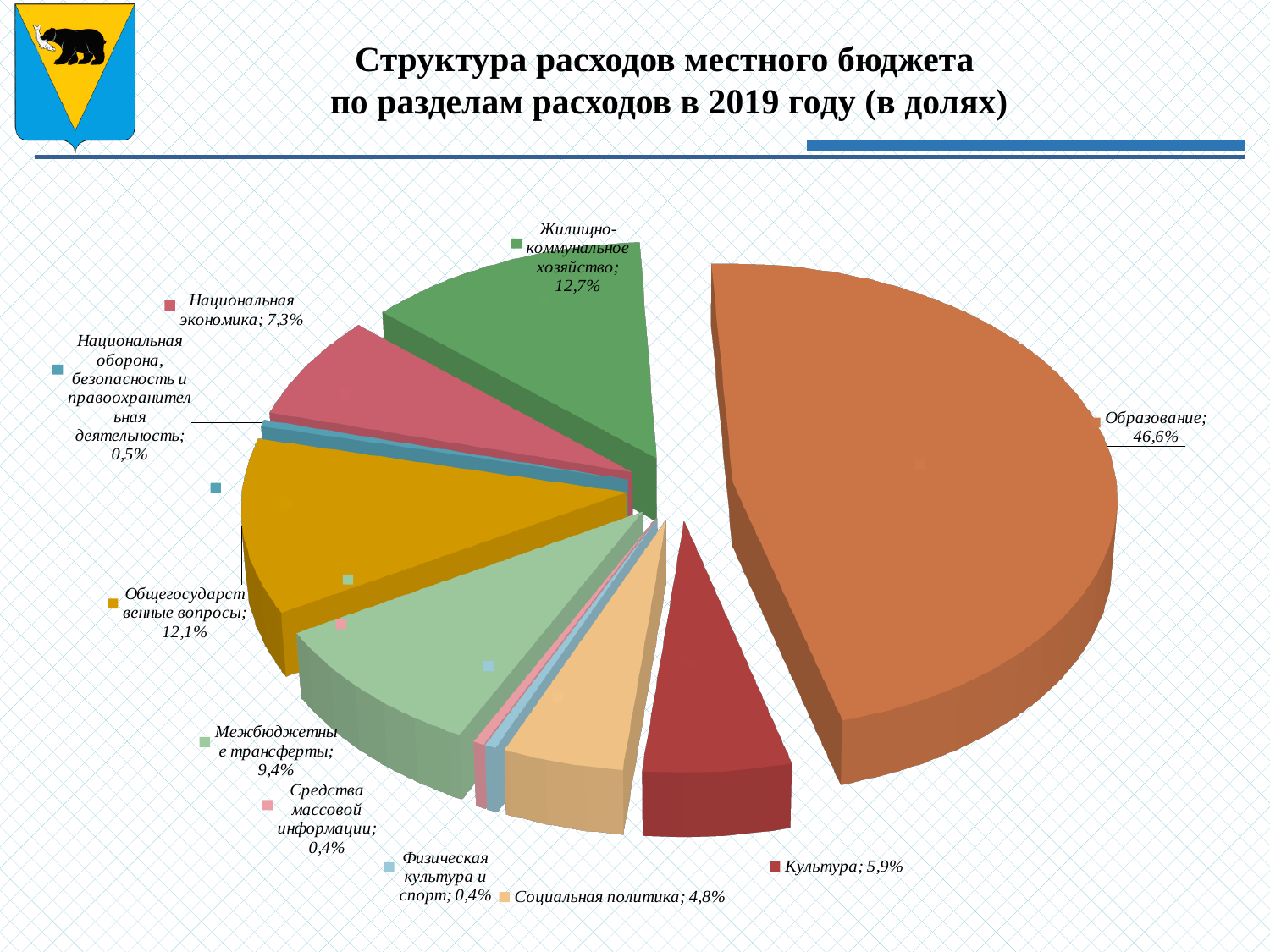
What year does the chart title refer to? 2019 What is the share for Межбюджетные трансферты? 9,4% What is the share for Общегосударственные вопросы? 12,1% Which has a larger share: Национальная экономика or Социальная политика? Национальная экономика What is the share for Жилищно-коммунальное хозяйство? 12,7% What is the difference between the shares of Жилищно-коммунальное хозяйство and Общегосударственные вопросы? 0,6% What is the share for Культура? 5,9% What share of local budget expenditure goes to Образование? 46,6% What is the difference between the shares of Культура and Социальная политика? 1,1% Which section has the largest share of expenditure? Образование How many expenditure sections are shown in the pie chart? 10 What type of chart is shown on the slide? Pie chart